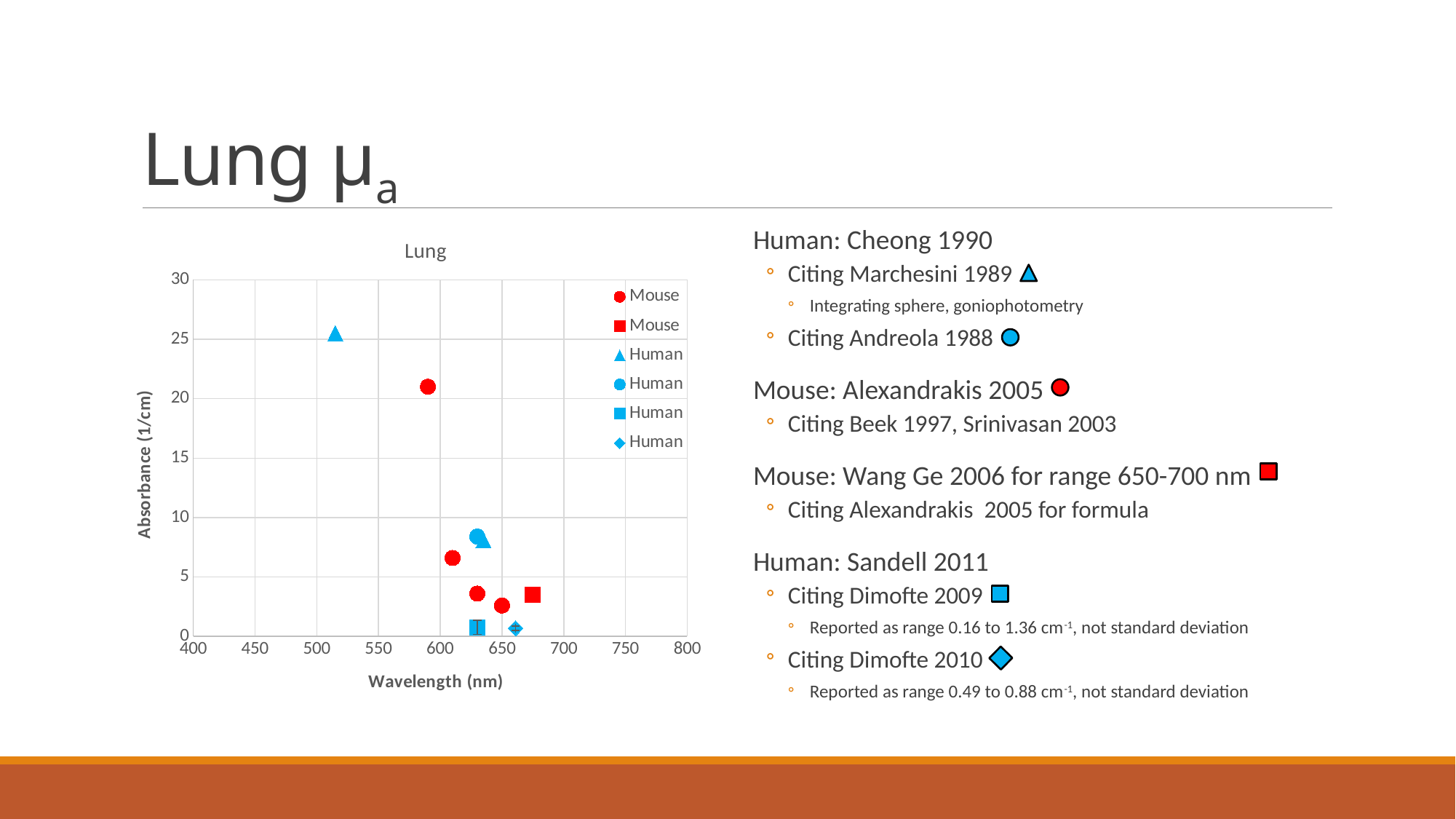
Is the absorbance of the Human diamond point near 660 nm greater or less than 5? less Which has the higher absorbance: the Human triangle point near 515 nm or the Mouse circle point near 590 nm? the Human triangle point near 515 nm Is the absorbance of the Mouse square point near 675 nm greater or less than 5? less What is the title of the chart? Lung How many series does the legend of the Lung chart list? 6 Is the absorbance of the Mouse circle point near 590 nm greater or less than 15? greater How many points are plotted for the Mouse series with square markers? 1 How many points are plotted for the Mouse series with circle markers? 4 What is the label of the vertical axis of the chart? Absorbance (1/cm) Which series contains the highest plotted point on the chart? Human (triangle markers) What kind of chart is shown on the slide? scatter chart